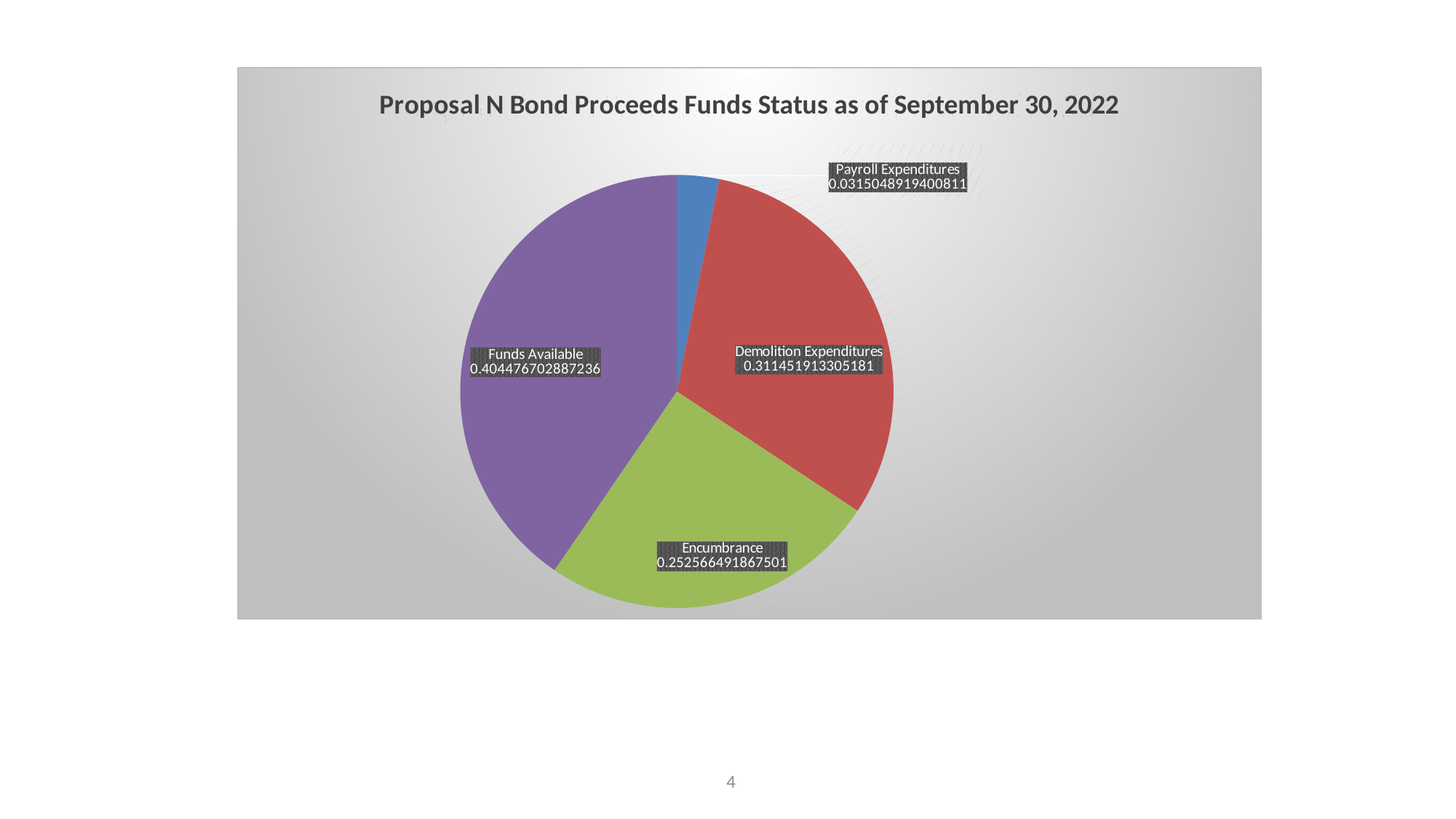
What is the difference between the values for Funds Available and Demolition Expenditures? 0.093024789582055 What is the value shown for Payroll Expenditures? 0.0315048919400811 Which slice of the pie is the smallest? Payroll Expenditures Which is larger, Demolition Expenditures or Encumbrance? Demolition Expenditures What is the value shown for Encumbrance? 0.252566491867501 What is the value shown for Funds Available? 0.404476702887236 What is the value shown for Demolition Expenditures? 0.311451913305181 What kind of chart is shown on the slide? pie chart What is the title of the chart? Proposal N Bond Proceeds Funds Status as of September 30, 2022 How many slices does the pie chart have? 4 Which slice of the pie is the largest? Funds Available What colour is the Funds Available slice? purple